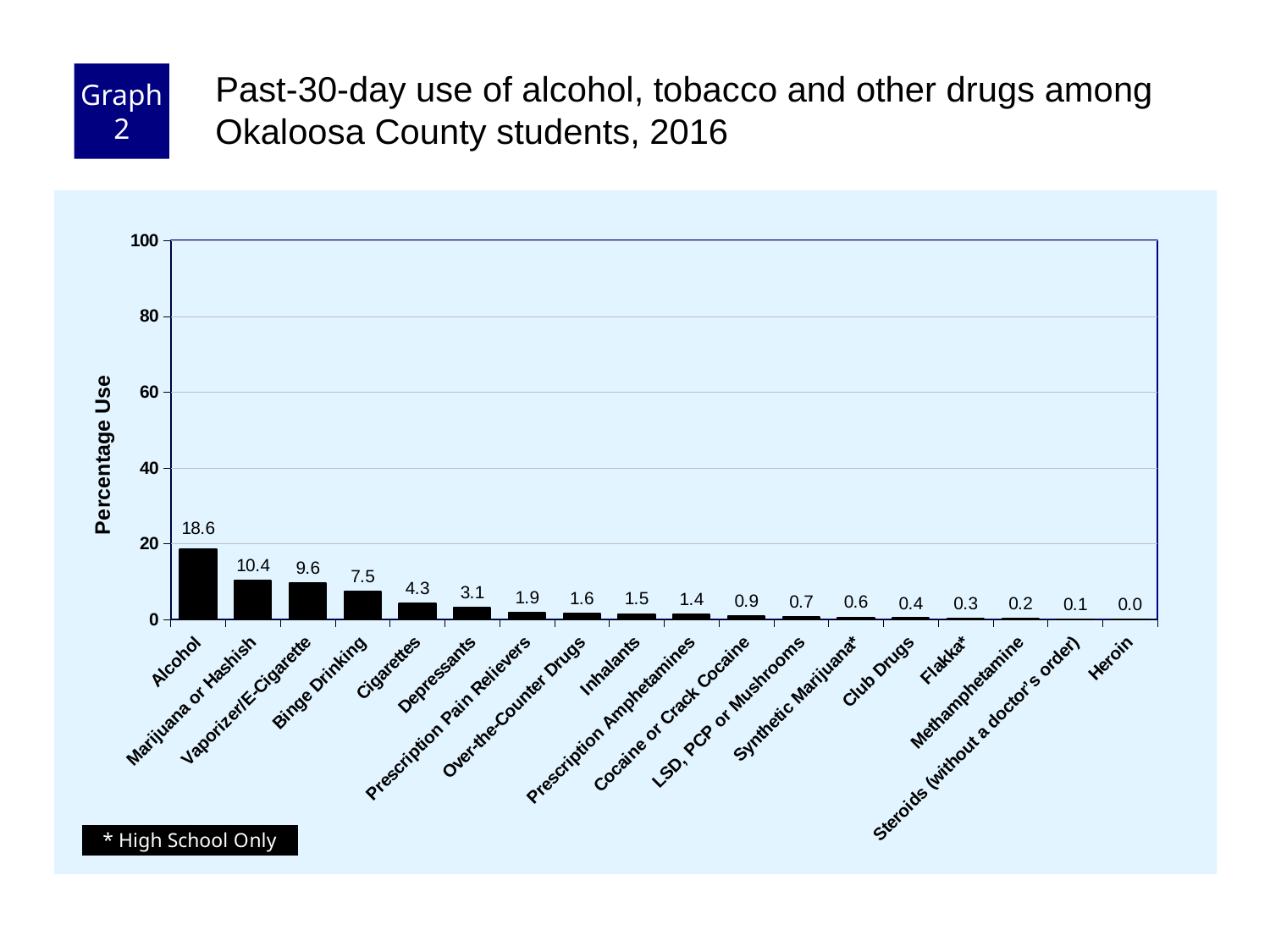
Which has a higher percentage use, Depressants or Inhalants? Depressants How many categories are shown on the x axis? 18 What is the percentage use for Vaporizer/E-Cigarette? 9.6 What kind of chart is shown on the slide? Bar chart Do the values rise or fall moving from left to right along the x axis? Fall What is the percentage use for Alcohol? 18.6 Which category has the highest percentage use? Alcohol What is the difference in percentage use between Alcohol and Marijuana or Hashish? 8.2 What is the difference in percentage use between Binge Drinking and Cigarettes? 3.2 What is the percentage use for Cigarettes? 4.3 Which category has the lowest percentage use? Heroin What is the percentage use for Synthetic Marijuana*? 0.6